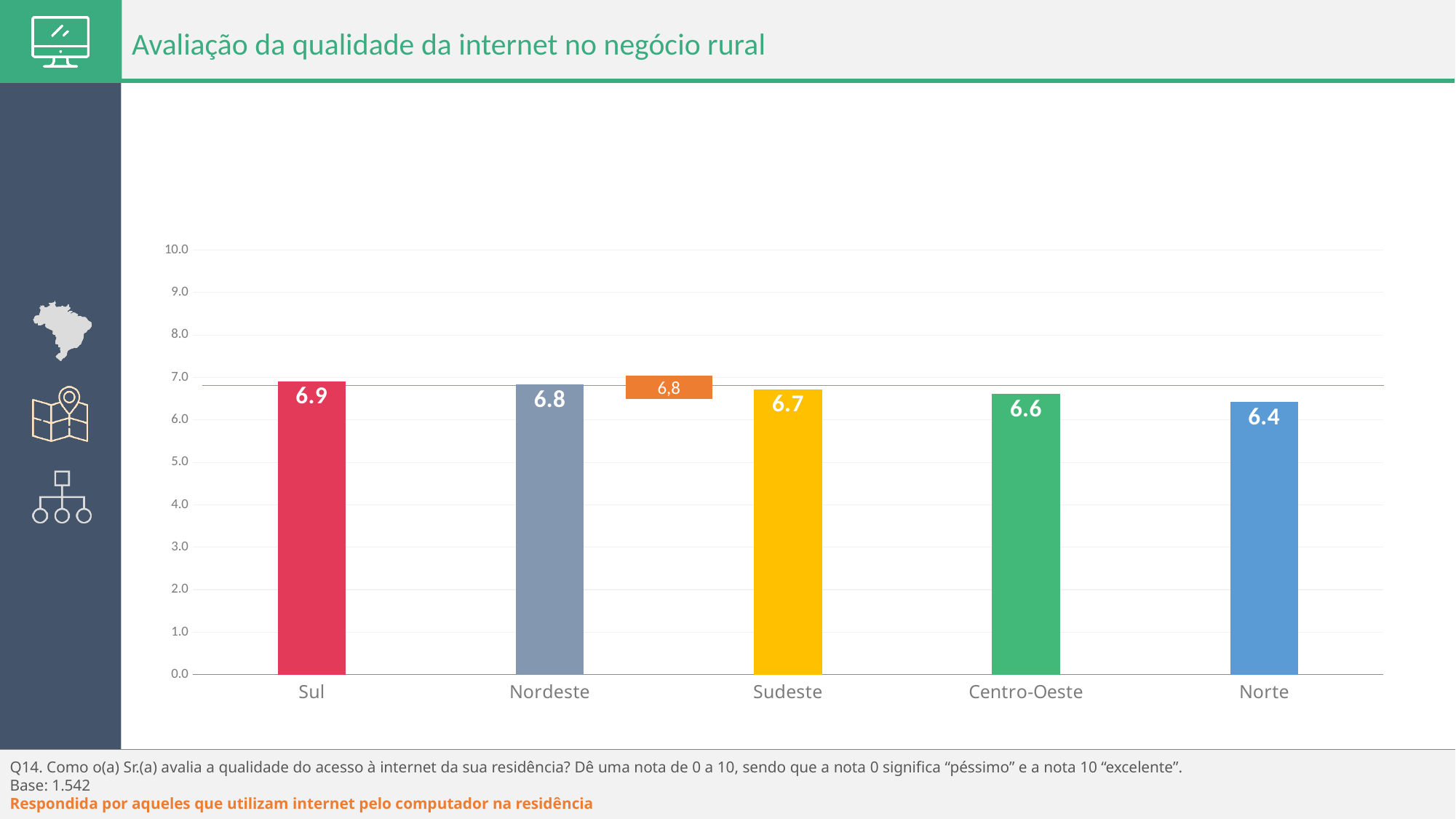
What value is shown in the orange label on the horizontal reference line? 6,8 What is the value for Norte? 6.4 What is the value for Sul? 6.9 Is the value for Sudeste greater or less than 7.0? less What is the value for Centro-Oeste? 6.6 How many regions are shown on the x axis? 5 Do the values rise or fall from Sul to Norte along the x axis? fall What is the difference between the values for Sul and Norte? 0.5 Which is larger, the value for Nordeste or the value for Centro-Oeste? Nordeste Which region has the highest value? Sul What kind of chart is shown on the slide? bar chart Which region has the lowest value? Norte